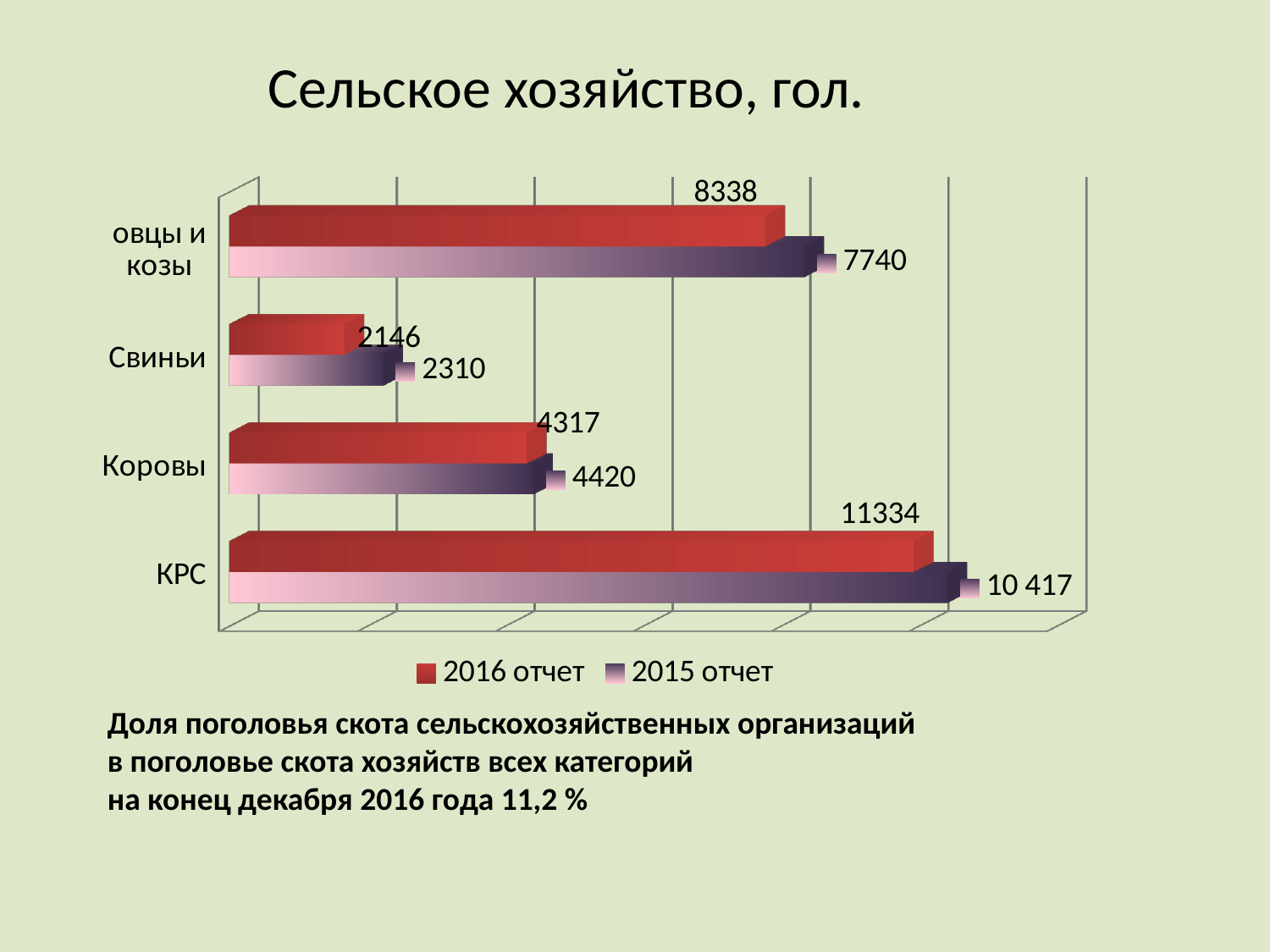
How many series does the legend list? 2 What is the value for КРС in the 2016 отчет series? 11334 What is the value for Коровы in the 2015 отчет series? 4420 What is the value for Свиньи in the 2015 отчет series? 2310 What kind of chart is shown on the slide? Bar chart Which is larger for Свиньи: the 2016 отчет value or the 2015 отчет value? 2015 отчет Which category has the highest value in the 2016 отчет series? КРС What is the difference between the 2015 отчет and 2016 отчет values for Коровы? 103 What is the difference between the 2016 отчет and 2015 отчет values for овцы и козы? 598 Which category has the lowest value in the 2015 отчет series? Свиньи How many categories are shown on the chart? 4 What is the value for овцы и козы in the 2016 отчет series? 8338